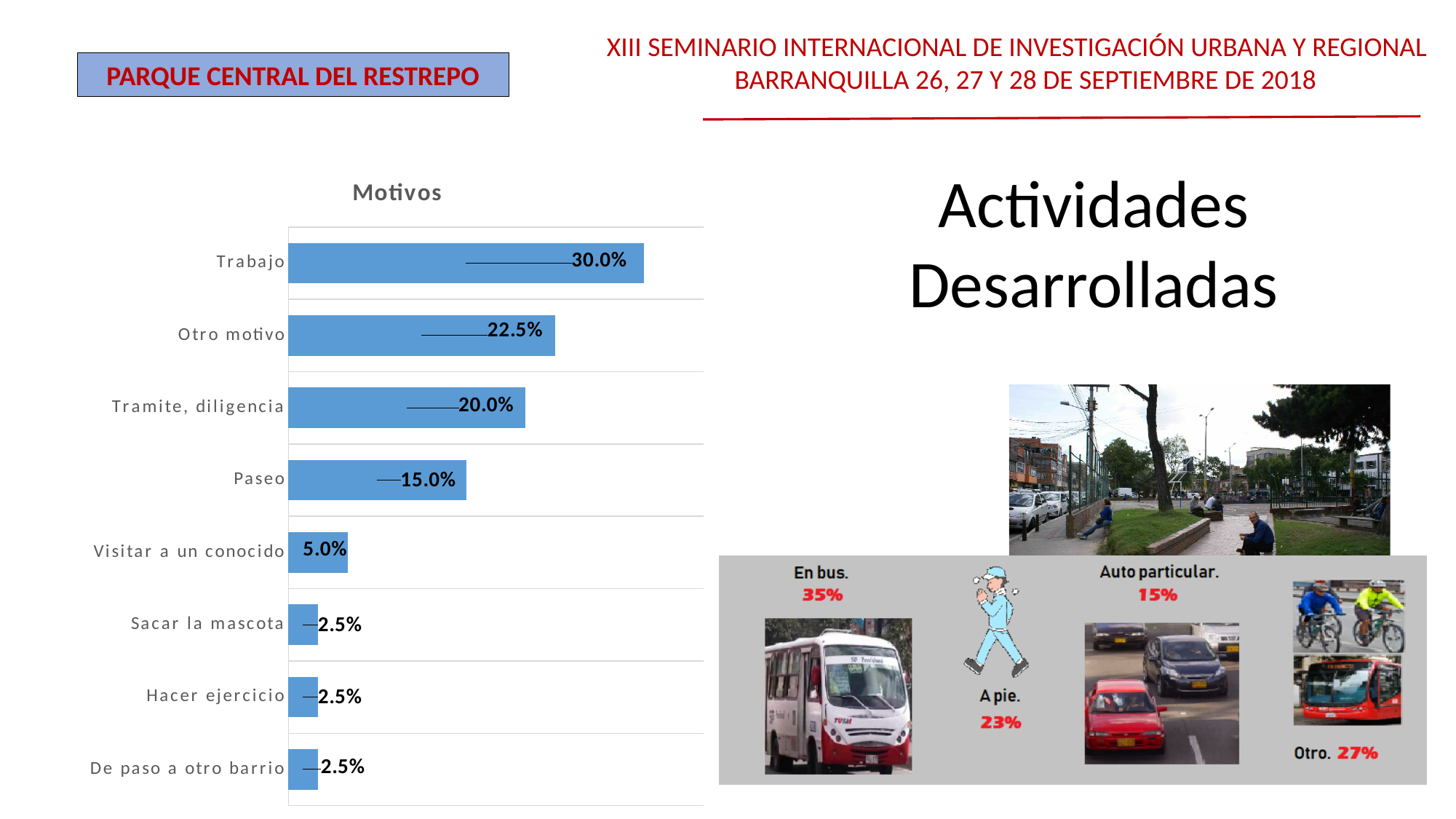
What is the difference between Paseo and Visitar a un conocido in the Motivos chart? 10.0% What is the difference between Trabajo and Otro motivo in the Motivos chart? 7.5% What is the value for Paseo in the Motivos chart? 15.0% What kind of chart is the Motivos chart? Bar chart How many categories are shown in the Motivos chart? 8 Which is larger in the Motivos chart, Tramite, diligencia or Paseo? Tramite, diligencia What is the value for Trabajo in the Motivos chart? 30.0% What is the value for Otro motivo in the Motivos chart? 22.5% Which category has the highest value in the Motivos chart? Trabajo What is the value for Sacar la mascota in the Motivos chart? 2.5% What is the value for Tramite, diligencia in the Motivos chart? 20.0% What is the value for Visitar a un conocido in the Motivos chart? 5.0%